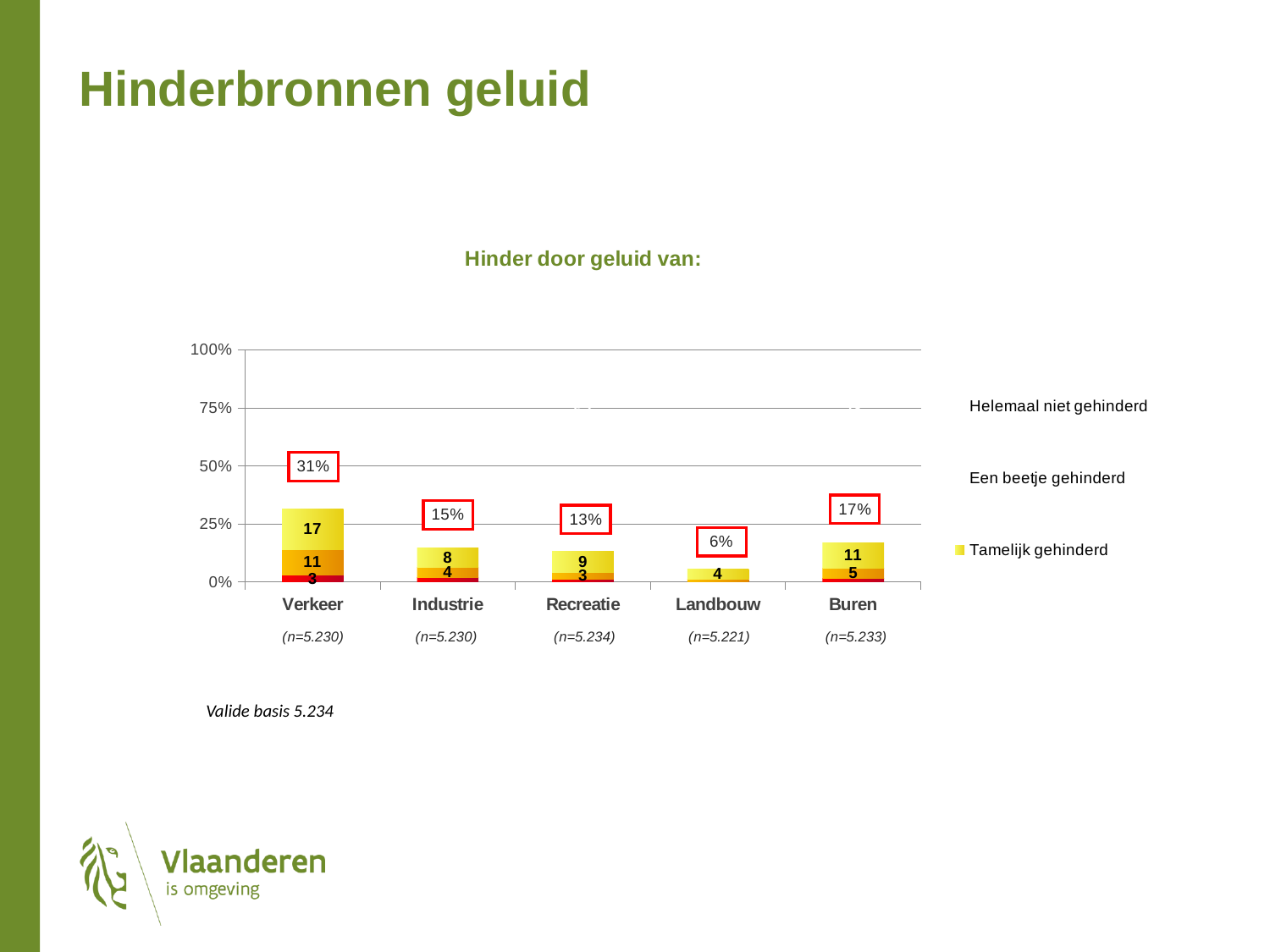
Is the total bar height for Verkeer greater or less than 25%? greater What value is printed on the 'Tamelijk gehinderd' (yellow) segment of the Verkeer bar? 17 Which has a higher boxed total, Industrie or Recreatie? Industrie What is the difference between the boxed total for Verkeer (31%) and the boxed total for Buren (17%)? 14 percentage points What is the total percentage shown in the red box above the Verkeer bar? 31% What is the title of the chart? Hinder door geluid van: Which noise source has the lowest total percentage of people hindered? Landbouw What kind of chart is shown on the slide? Stacked bar chart What sample size (n) is shown under the Landbouw category? n=5.221 How many noise source categories are shown on the x axis? 5 What value is printed on the 'Tamelijk gehinderd' (yellow) segment of the Buren bar? 11 Which noise source has the highest total percentage of people hindered? Verkeer